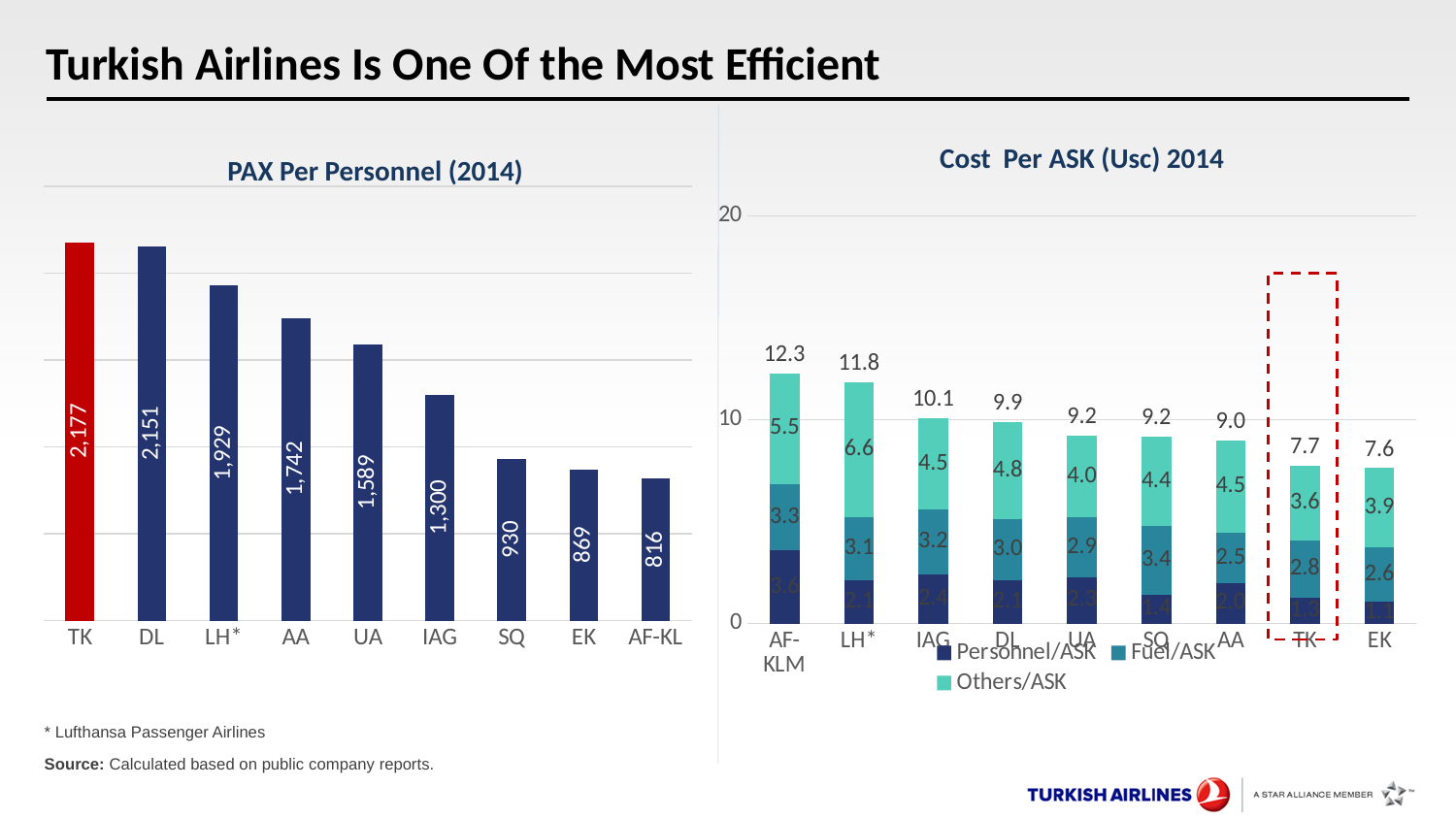
In the PAX Per Personnel (2014) chart, which airline has the lowest value? AF-KL In the Cost Per ASK (Usc) 2014 chart, is the total for IAG greater or less than 10? greater In the PAX Per Personnel (2014) chart, what is the difference between the values for LH* and AA? 187 In the Cost Per ASK (Usc) 2014 chart, what is the total cost per ASK for AF-KLM? 12.3 In the PAX Per Personnel (2014) chart, what is the value for IAG? 1,300 In the PAX Per Personnel (2014) chart, what is the value for TK? 2,177 How many series does the legend of the Cost Per ASK (Usc) 2014 chart list? 3 In the Cost Per ASK (Usc) 2014 chart, which airline has the lowest total cost per ASK? EK What kind of chart is the Cost Per ASK (Usc) 2014 chart? stacked bar chart In the PAX Per Personnel (2014) chart, do the values rise or fall from left to right? fall In the PAX Per Personnel (2014) chart, how many airlines are shown? 9 In the Cost Per ASK (Usc) 2014 chart, what is the Others/ASK value for LH*? 6.6